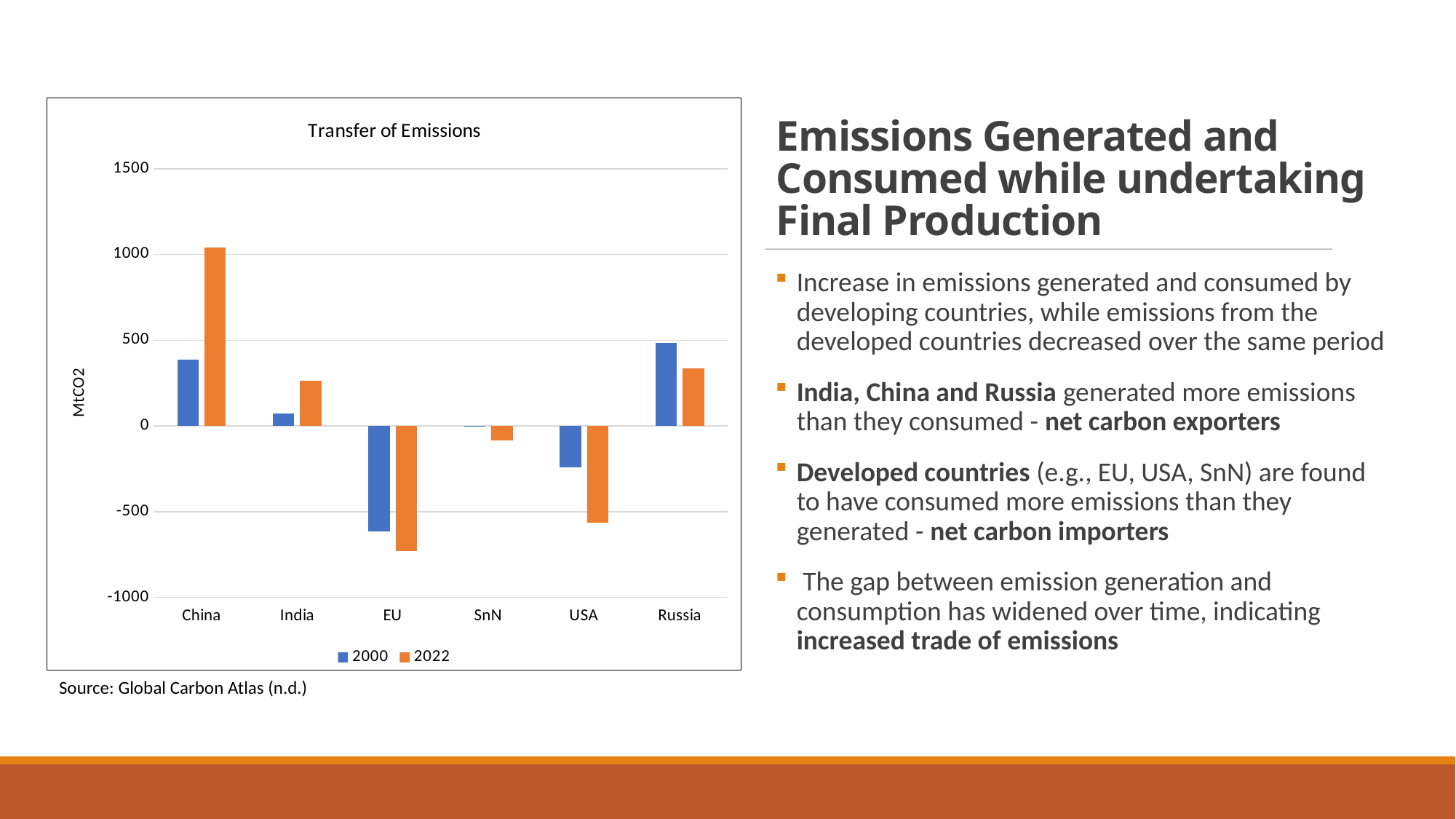
What is the title of the chart? Transfer of Emissions Is the value for USA in 2022 greater or less than -500? less Which country or region has the lowest value for 2022? EU Which country or region has the highest value for 2000? Russia Which is larger, the 2022 value for China or the 2022 value for Russia? China How many series does the chart's legend list? 2 Which country or region has the lowest value for 2000? EU Which country or region has the highest value for 2022? China How many countries or regions are shown on the x axis of the chart? 6 What is the label on the chart's y axis? MtCO2 What kind of chart is shown on the slide? bar chart Is the value for China in 2022 greater or less than 500? greater